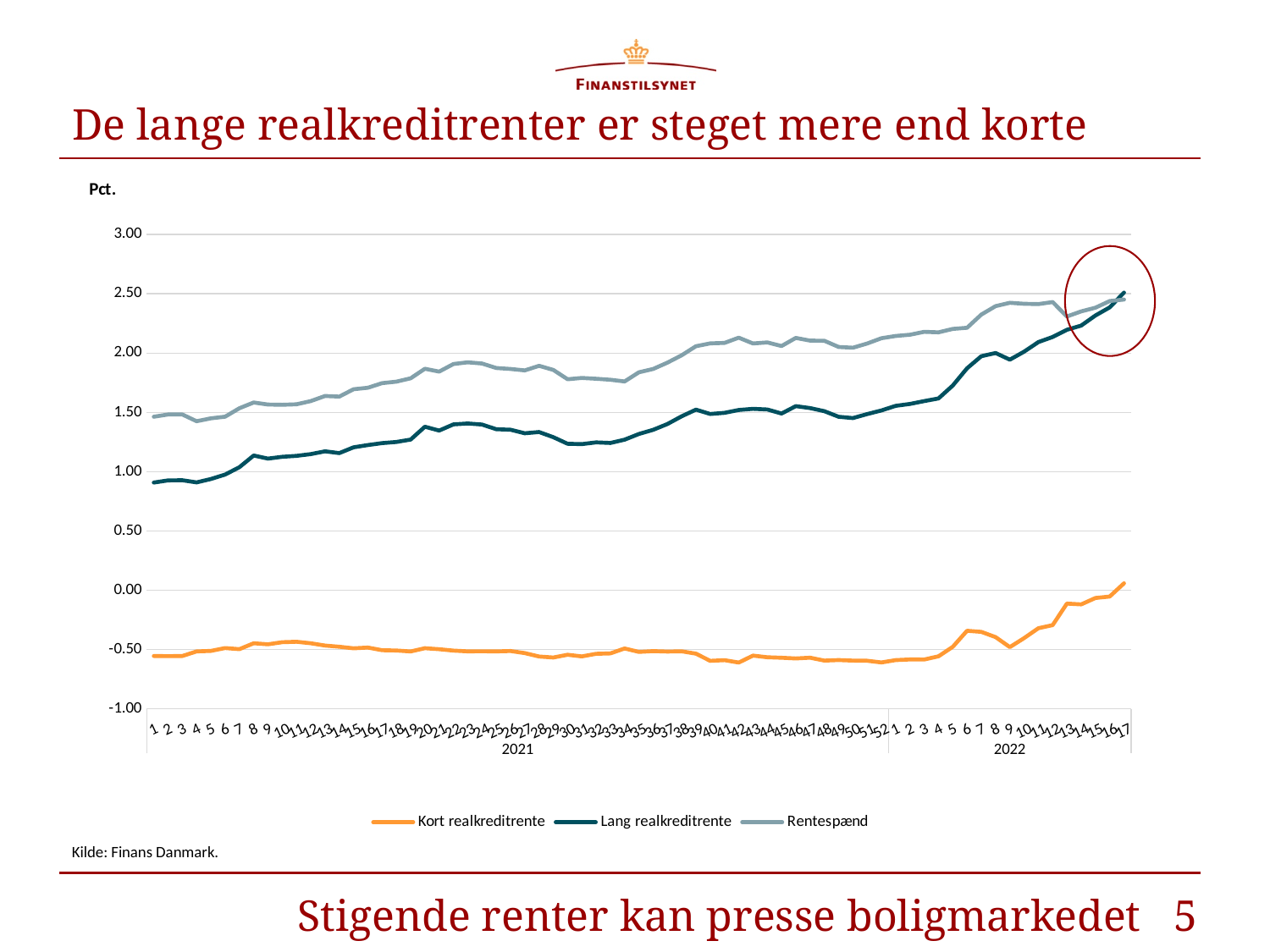
Does the Lang realkreditrente series rise or fall overall from the start of 2021 to the end of the series in 2022? rise What type of chart is shown on the slide? line chart Which series has the lowest values throughout the chart? Kort realkreditrente Does the Kort realkreditrente series rise or fall overall from the start of 2021 to the end of the series in 2022? rise How many series does the legend list? 3 Is the value of Lang realkreditrente at week 1 of 2021 greater or less than 1.00? less Is the value of Rentespænd at the last point in 2022 greater or less than 2.00? greater Is the value of Lang realkreditrente at the last point in 2022 greater or less than 2.00? greater Which series is shown in orange in the legend? Kort realkreditrente What is the title of the chart slide? De lange realkreditrenter er steget mere end korte Which series has the higher value at week 1 of 2021, Rentespænd or Lang realkreditrente? Rentespænd